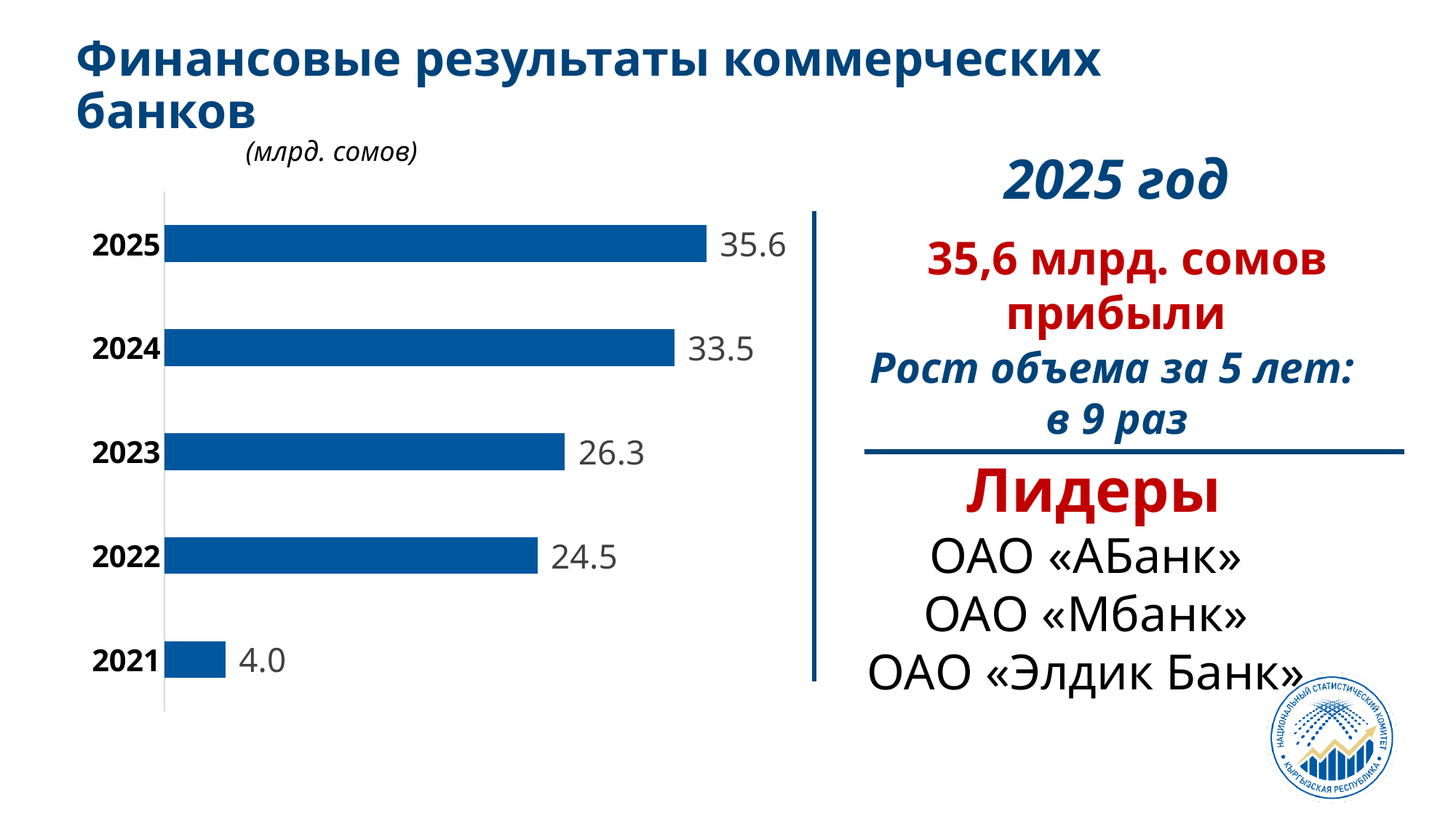
Which is larger, the value for 2024 or the value for 2023? 2024 Which year has the lowest value? 2021 What is the value for 2023? 26.3 Which year has the highest value? 2025 What unit is given for the chart values? млрд. сомов How many years are shown in the chart? 5 What is the difference between the values for 2025 and 2024? 2.1 What is the value for 2021? 4.0 What is the difference between the values for 2023 and 2022? 1.8 Do the values rise or fall from 2021 to 2025? rise What kind of chart is shown on the slide? bar chart What is the value for 2025? 35.6